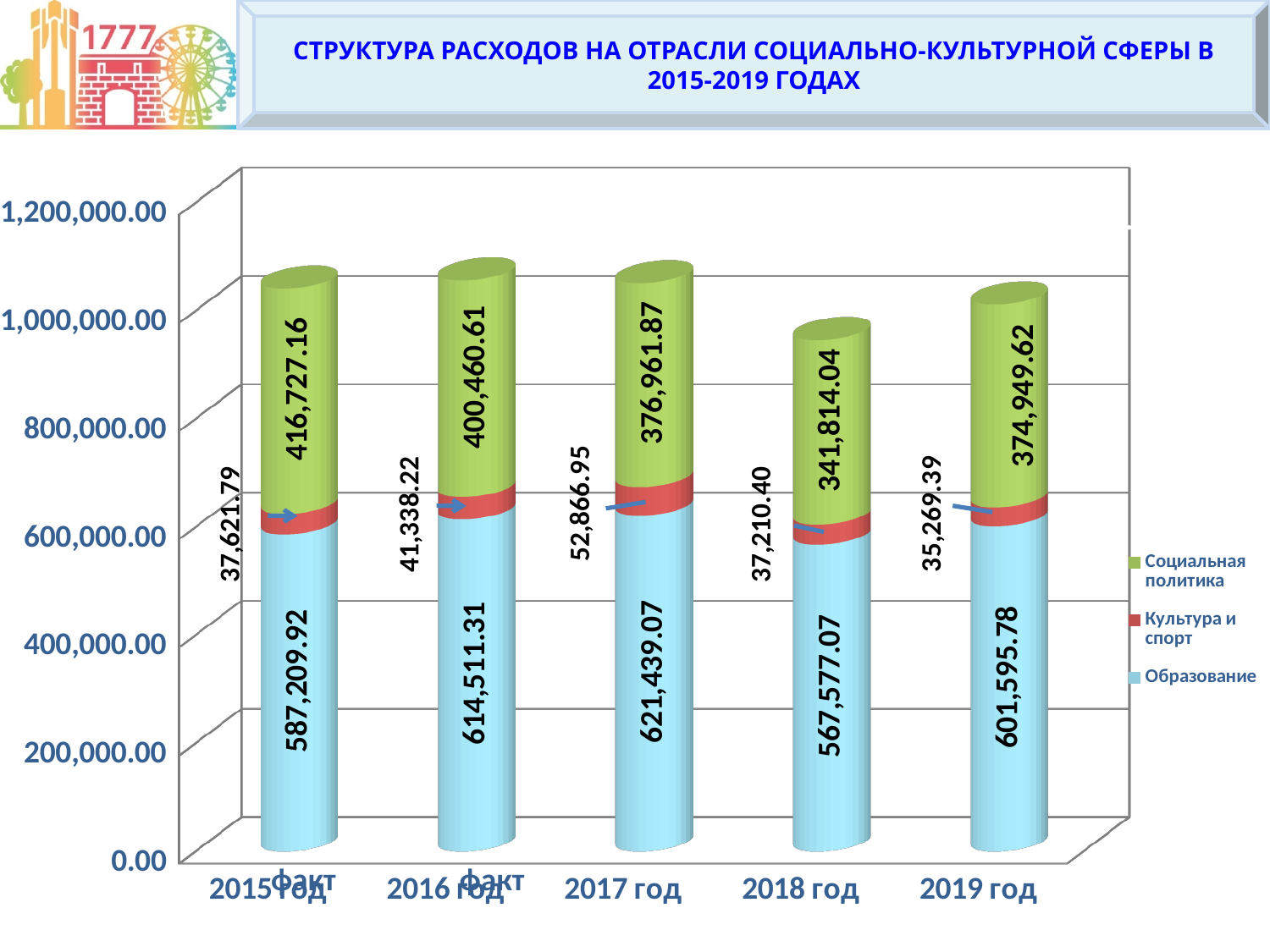
How many series does the legend list? 3 In which year is the value for Образование the lowest? 2018 год What is the value for Социальная политика in 2019 год? 374,949.62 Which is larger: Образование in 2016 год or Образование in 2019 год? 2016 год What is the value for Культура и спорт in 2018 год? 37,210.40 What is the difference between the Социальная политика values for 2015 год and 2018 год? 74,913.12 What is the total of the stacked bar for 2018 год? 946,601.51 In which year is the value for Социальная политика the highest? 2015 год What type of chart is shown on the slide? stacked bar chart What is the value for Образование in 2017 год? 621,439.07 How many year categories are shown on the x axis? 5 In which year is the value for Культура и спорт the highest? 2017 год